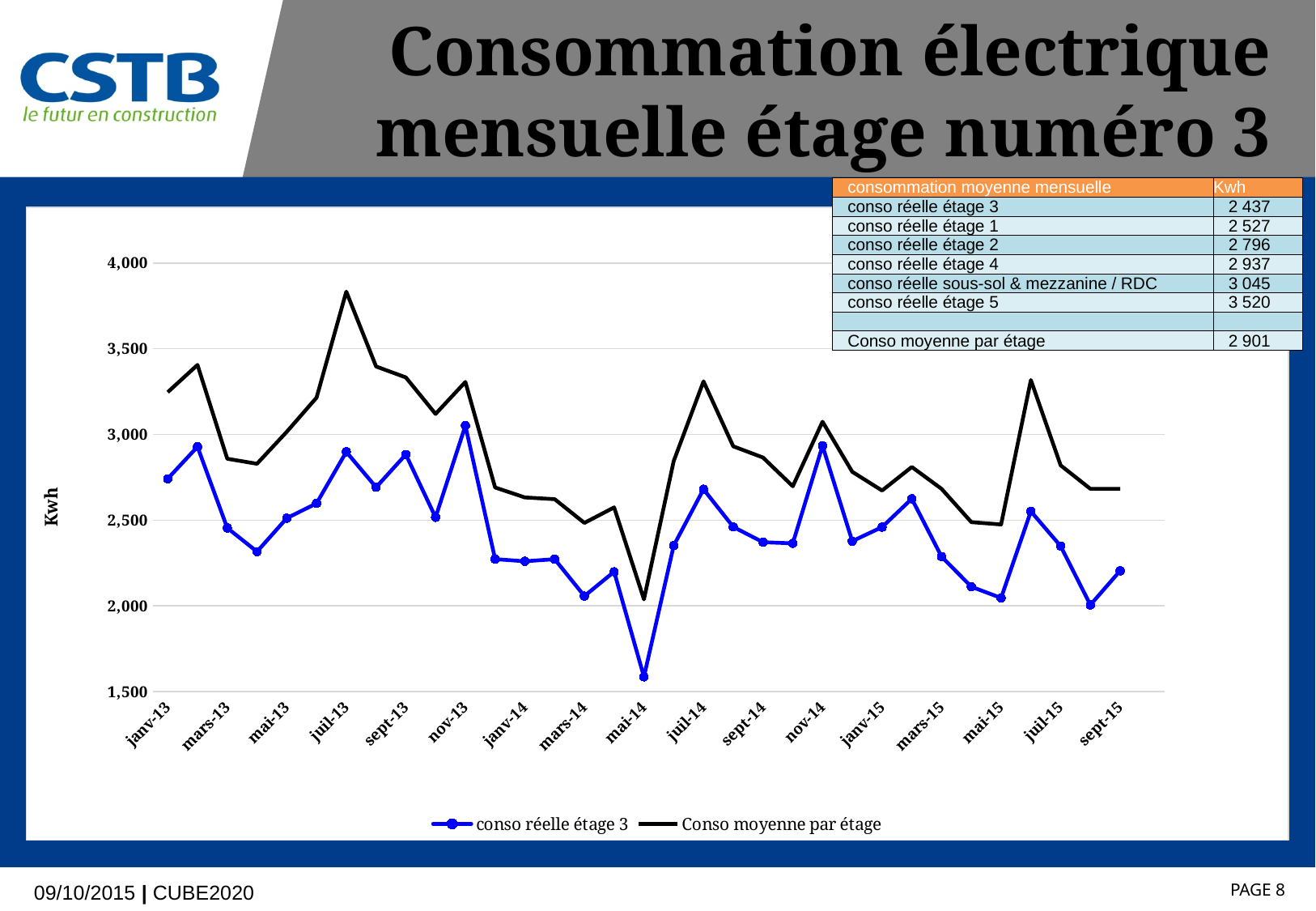
Does the conso réelle étage 3 series rise or fall between mai-14 and juil-14? rise In which month does the Conso moyenne par étage series reach its highest value? juil-13 What is the label on the vertical axis of the chart? Kwh Is the value of conso réelle étage 3 for mai-14 greater or less than 2,000? less What kind of chart is shown on the slide? line chart In which month does the conso réelle étage 3 series reach its lowest value? mai-14 What are the two series named in the chart legend? conso réelle étage 3 and Conso moyenne par étage Is the value of conso réelle étage 3 for sept-15 greater or less than 2,500? less Is the value of Conso moyenne par étage for juil-13 greater or less than 3,500? greater How many series does the chart legend list? 2 At juil-13, which series has the higher value: conso réelle étage 3 or Conso moyenne par étage? Conso moyenne par étage